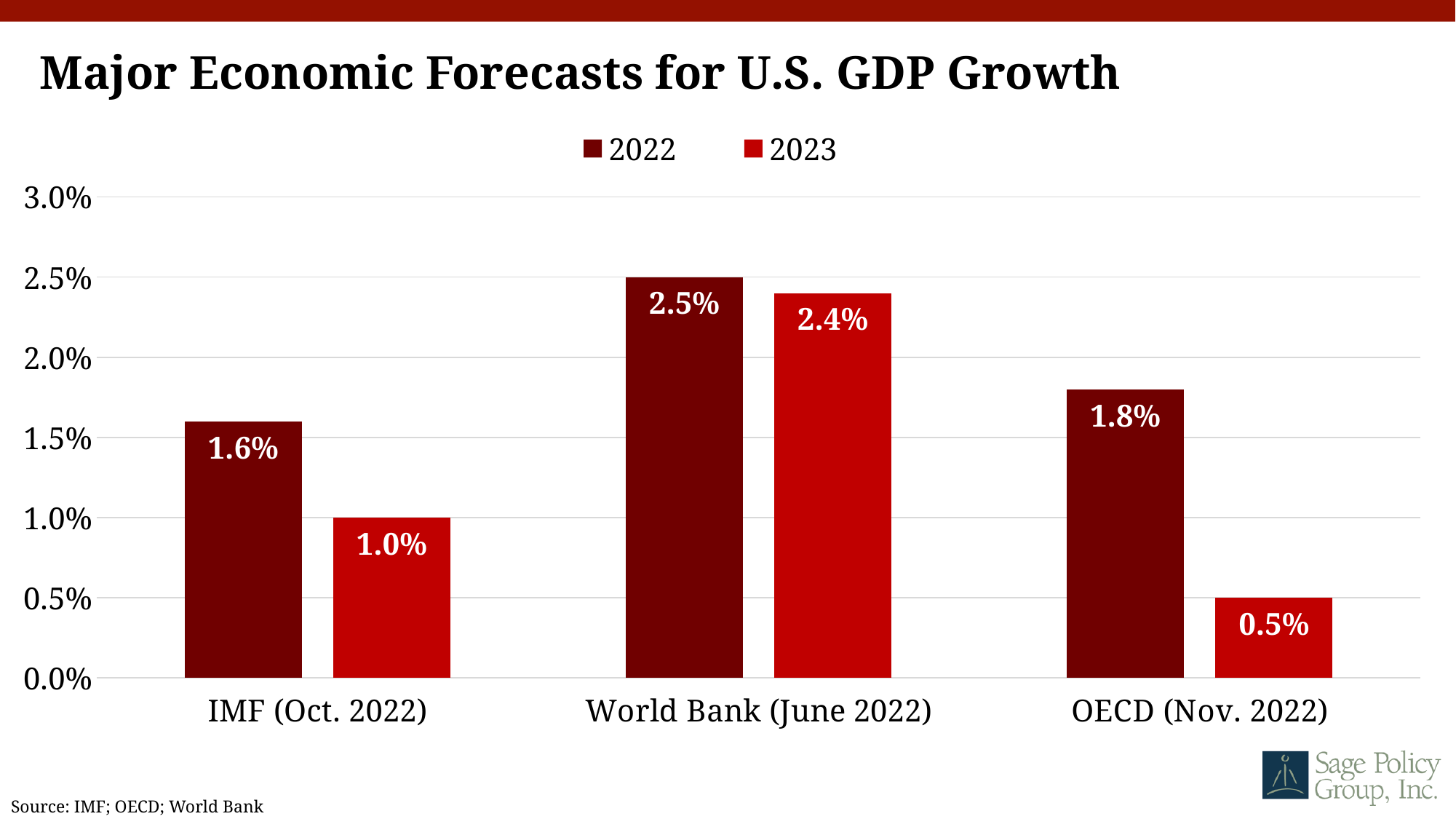
Which forecaster has the highest 2022 GDP growth forecast? World Bank (June 2022) What is the 2023 forecast for U.S. GDP growth from the OECD (Nov. 2022)? 0.5% What is the difference between the OECD's 2022 and 2023 forecasts? 1.3% How many series does the legend list? 2 What is the title of the chart? Major Economic Forecasts for U.S. GDP Growth Which is larger: the IMF's 2023 forecast or the OECD's 2023 forecast? IMF's 2023 forecast What is the 2023 forecast from the World Bank (June 2022)? 2.4% Which forecaster has the lowest 2023 GDP growth forecast? OECD (Nov. 2022) What kind of chart is shown on the slide? Bar chart How many forecasters are shown on the x axis? 3 What is the 2022 forecast for U.S. GDP growth from the IMF (Oct. 2022)? 1.6% What is the difference between the World Bank's 2022 and 2023 forecasts? 0.1%